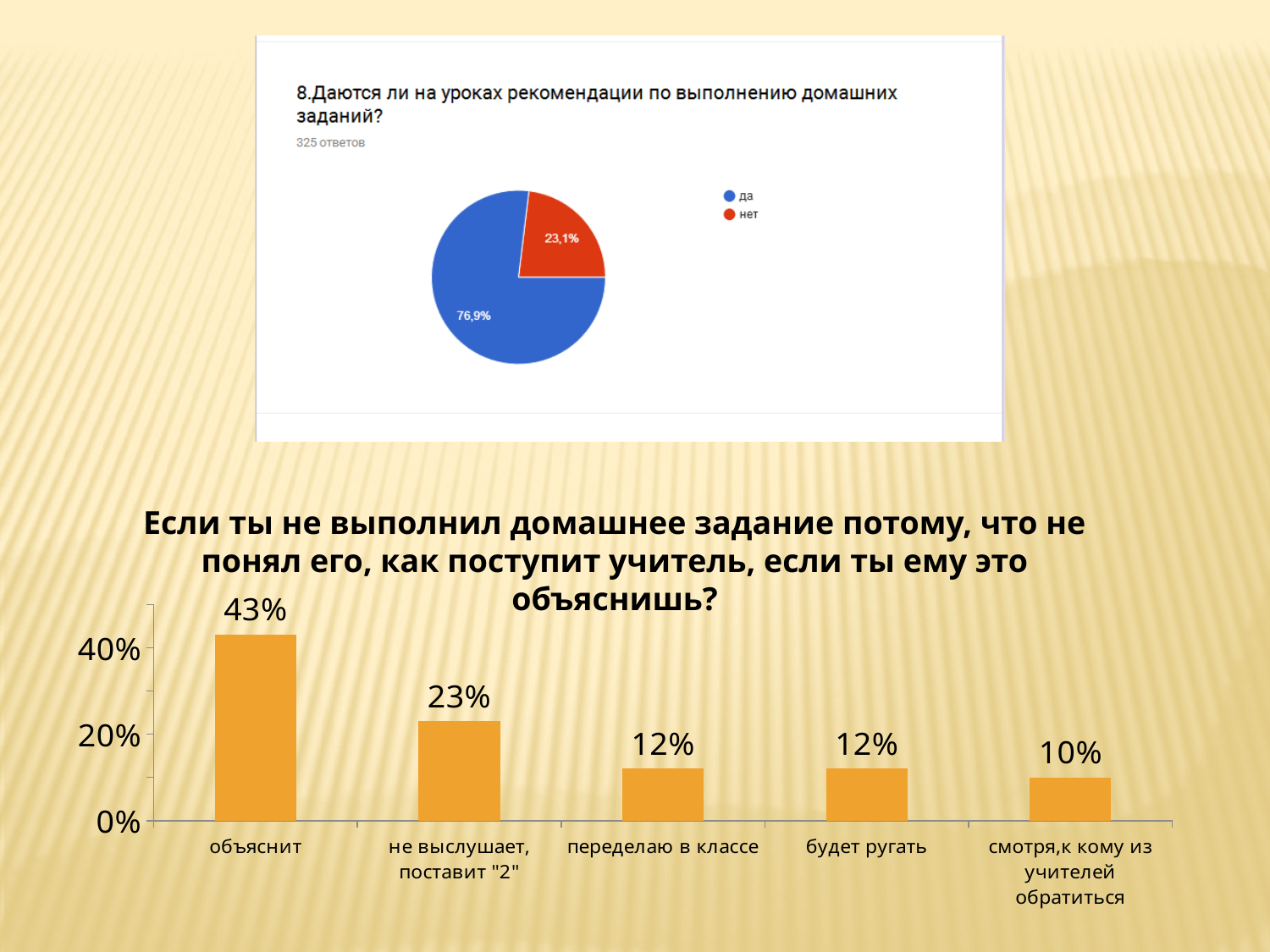
How many responses does the pie chart at the top of the slide report? 325 ответов How many categories are shown in the bar chart at the bottom of the slide? 5 In the pie chart at the top of the slide, what share of responses is "нет"? 23,1% In the pie chart at the top of the slide, what share of responses is "да"? 76,9% What type of chart is shown at the bottom of the slide? bar chart In the bar chart at the bottom of the slide, what is the difference between the values for "объяснит" and "не выслушает, поставит "2""? 20% In the bar chart at the bottom of the slide, what is the value for "смотря,к кому из учителей обратиться"? 10% In the bar chart at the bottom of the slide, what is the value for "не выслушает, поставит "2""? 23% In the bar chart at the bottom of the slide, what is the value for "объяснит"? 43% In the pie chart at the top of the slide, which answer has the larger slice, "да" or "нет"? да In the bar chart at the bottom of the slide, which category has the lowest value? смотря,к кому из учителей обратиться In the bar chart at the bottom of the slide, which category has the highest value? объяснит